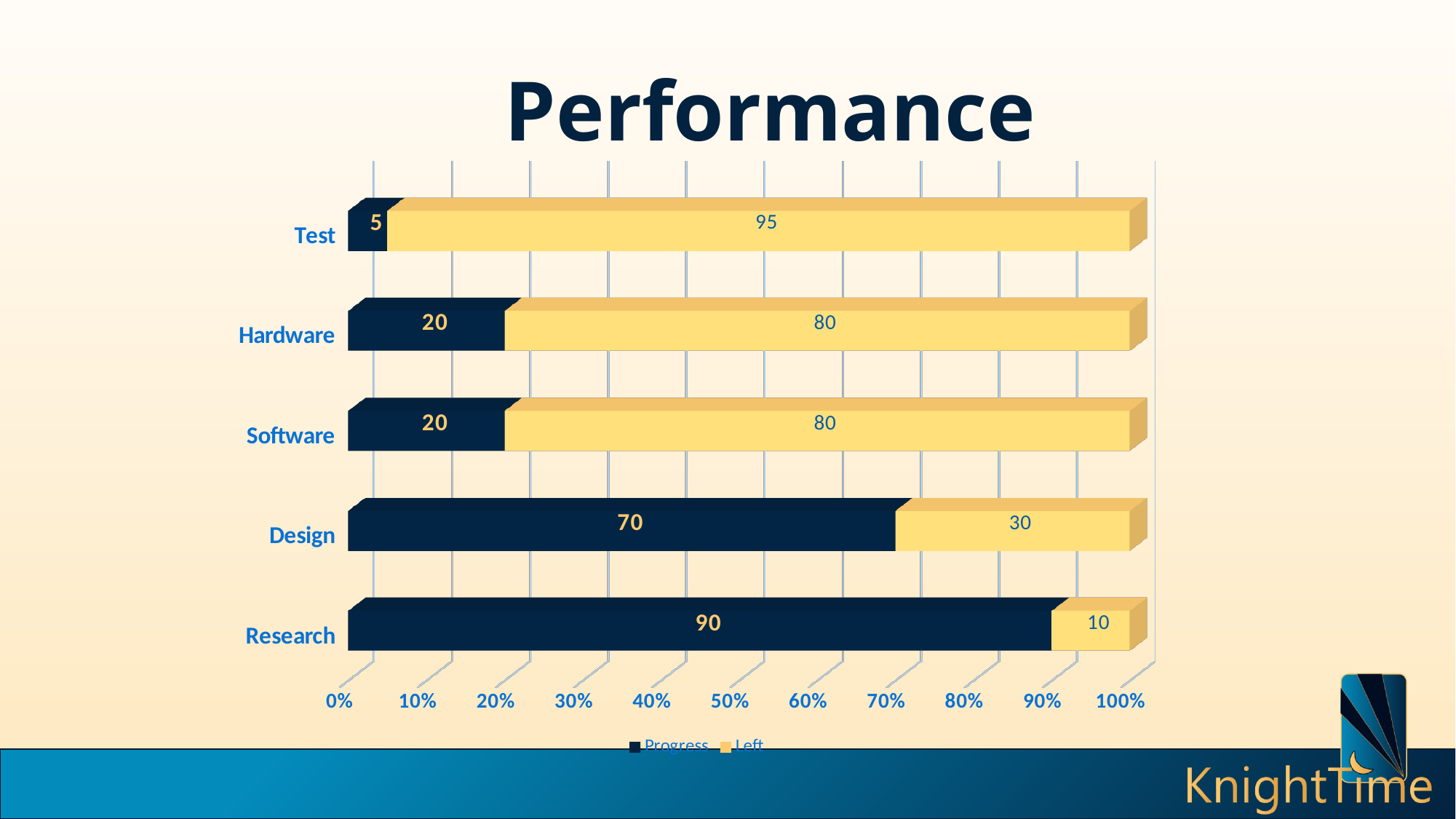
What is the Left value for Test? 95 What is the title of the chart? Performance What kind of chart is shown on the slide? Stacked bar chart Which category has the lowest Progress value? Test How many categories are shown on the chart? 5 What is the difference between the Progress values for Research and Design? 20 What is the Progress value for Design? 70 Which is larger, the Left value for Design or the Left value for Research? Design What is the Progress value for Research? 90 Which category has the highest Progress value? Research What is the Left value for Hardware? 80 How many series does the legend list? 2